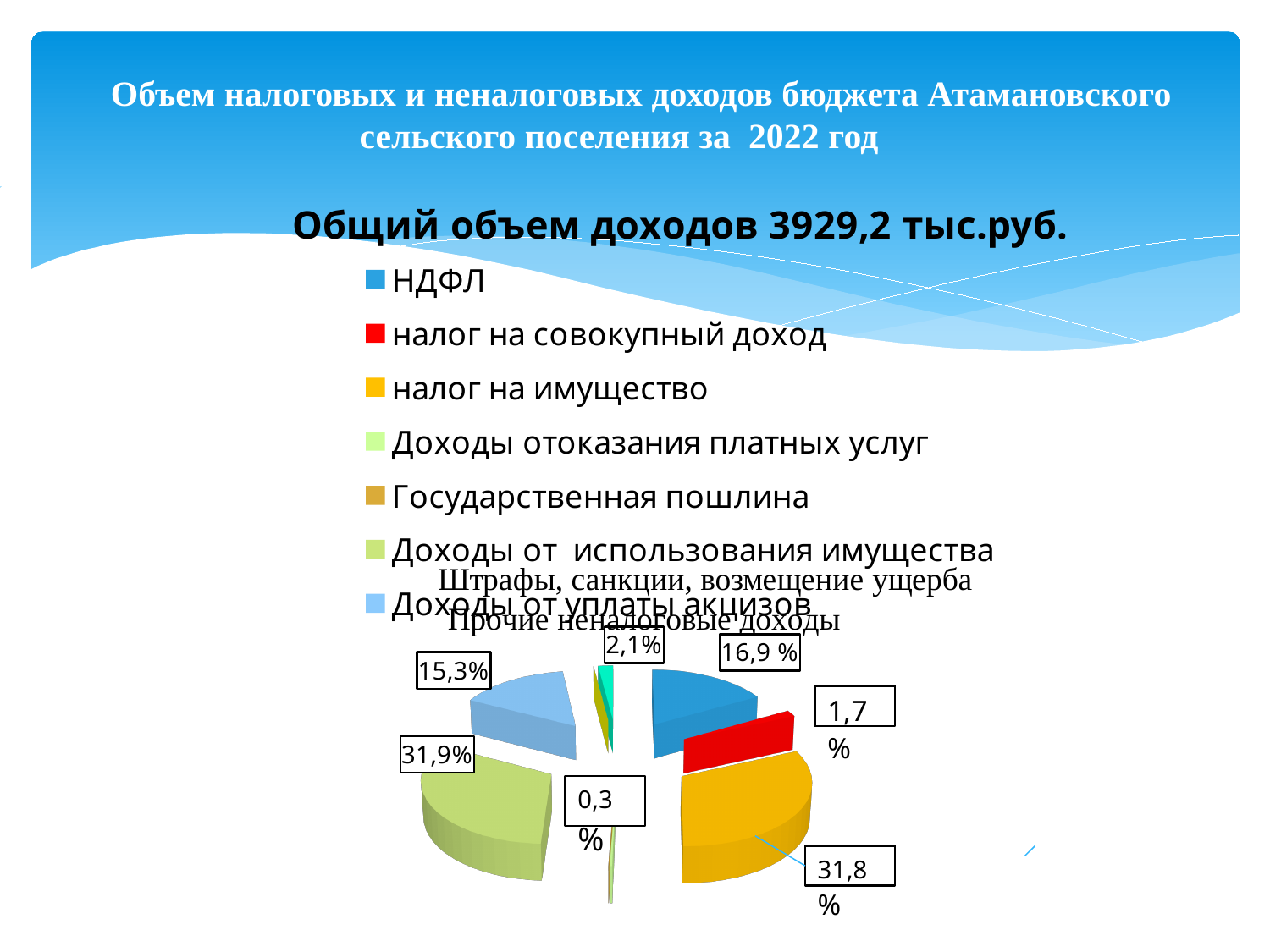
What is the smallest percentage label shown on the pie? 0,3 % Which is larger: the share for НДФЛ or the share for Доходы от уплаты акцизов? НДФЛ What percentage is shown for налог на совокупный доход? 1,7 % What kind of chart is shown on the slide? pie chart What colour is the slice for НДФЛ? blue What percentage is shown for НДФЛ? 16,9 % What percentage is shown for Доходы от использования имущества? 31,9% What is the title shown above the chart? Общий объем доходов 3929,2 тыс.руб. Which category has the largest share of the pie? Доходы от использования имущества What is the difference in percentage points between НДФЛ and Доходы от уплаты акцизов? 1,6 What percentage is shown for Доходы от уплаты акцизов? 15,3% What percentage is shown for налог на имущество? 31,8 %